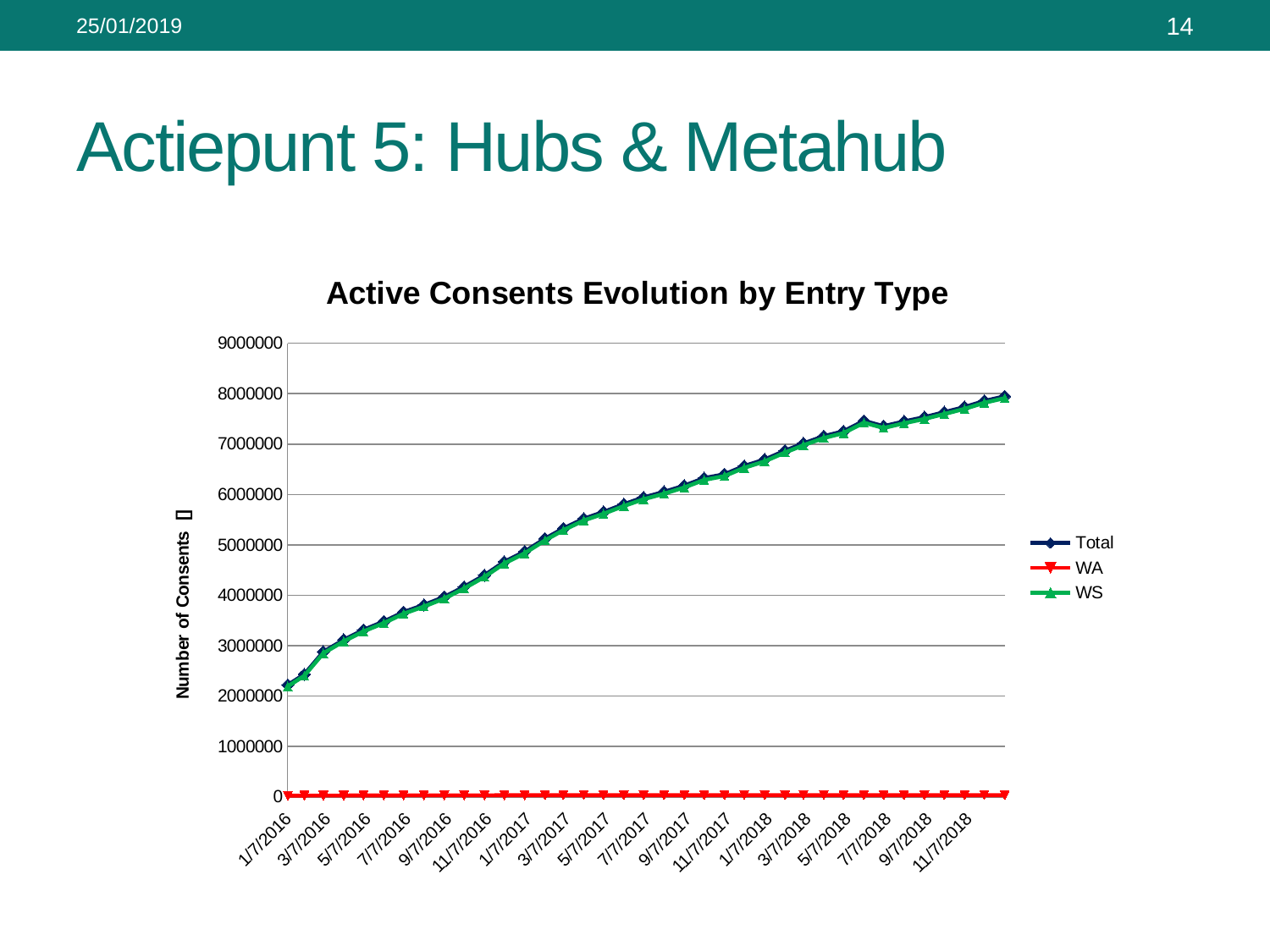
Is the value of WS at 7/7/2017 greater or less than 5000000? greater Is the value of WA at 1/7/2018 greater or less than 1000000? less Does the Total series rise or fall from 1/7/2016 to 11/7/2018? rise What kind of chart is shown on the slide? line chart What is the title of the chart? Active Consents Evolution by Entry Type How many series does the legend list? 3 Which series has the highest values throughout the chart? Total Is the value of Total at 11/7/2018 greater or less than 7000000? greater Which series has the lowest values throughout the chart? WA At 9/7/2017, which series has the larger value, WS or WA? WS What is the label of the vertical axis? Number of Consents